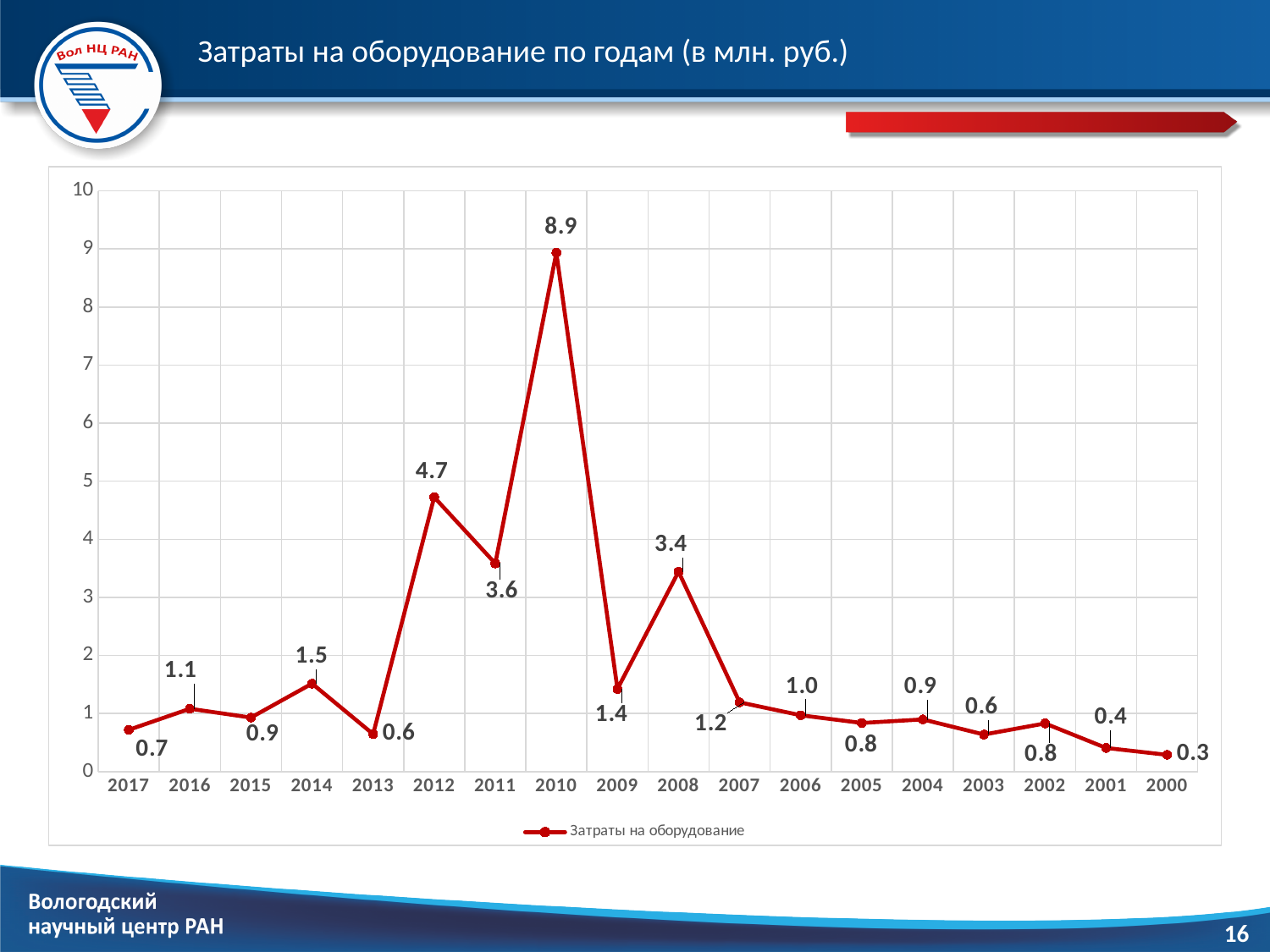
Moving along the x axis from 2002 to 2000, do the values rise or fall? fall What is the value for 2014? 1.5 What is the difference between the values for 2010 and 2012? 4.2 How many series does the legend list? 1 What is the value for 2008? 3.4 What is the value for 2010? 8.9 Which year has the highest value? 2010 How many years are plotted on the chart? 18 Which is larger, the value for 2011 or the value for 2008? 2011 What type of chart is shown on the slide? line chart What is the value for 2012? 4.7 Which year has the lowest value? 2000